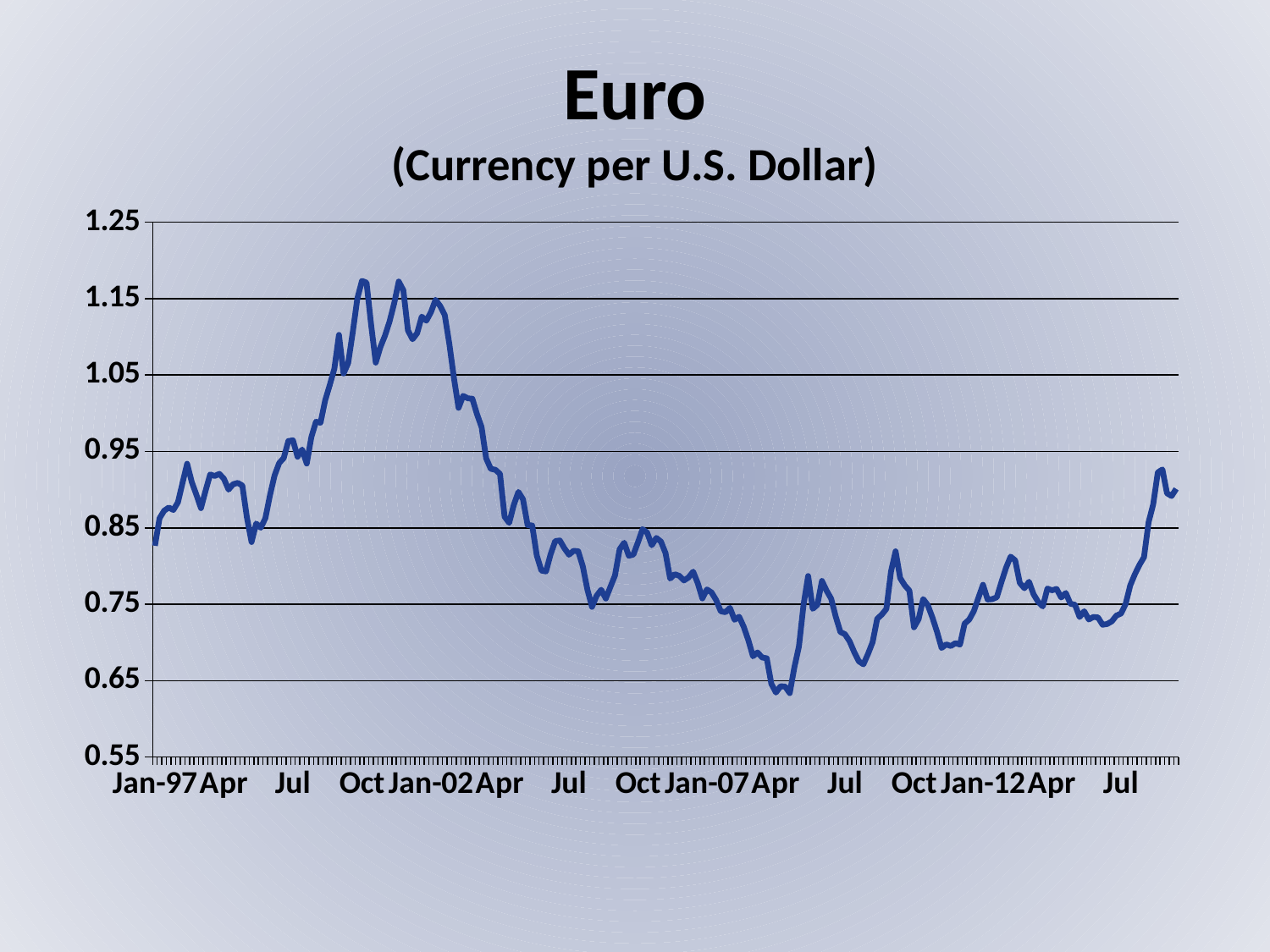
Is the peak value of the line greater or less than 1.15? greater Is the value at Jan-12 greater or less than 0.85? less What is the highest value shown on the y axis? 1.25 Does the line generally rise or fall between Jan-02 and Jan-07? fall What is the title of the chart? Euro (Currency per U.S. Dollar) Does the line rise or fall from the last Jul label to the end of the series? rise Is the value at Jan-97 greater or less than 0.75? greater Is the value at Jan-02 larger or smaller than the value at Jan-07? larger What kind of chart is shown on the slide? line chart